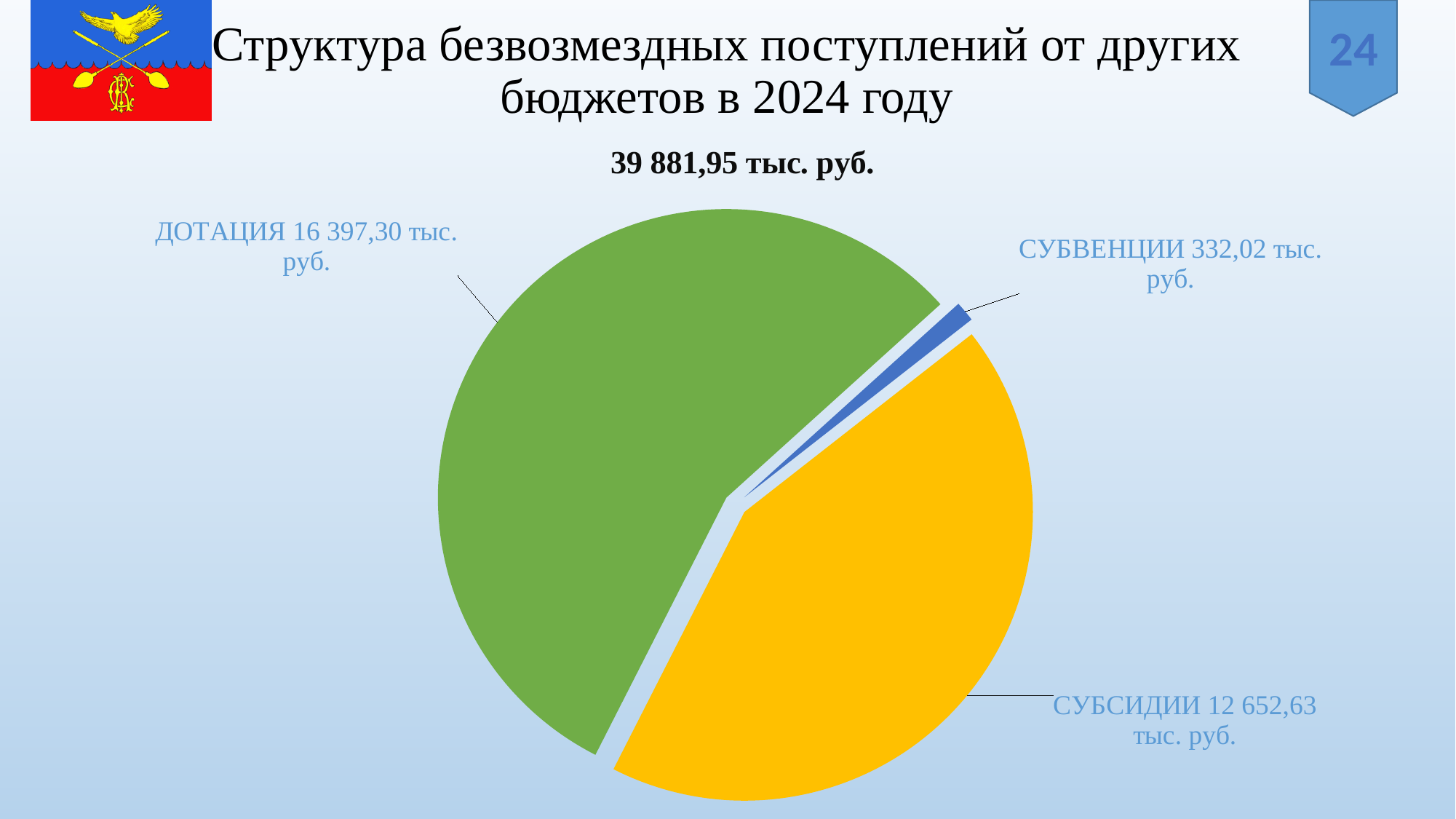
What kind of chart is shown on the slide? Pie chart What is the difference between the values for ДОТАЦИЯ and СУБСИДИИ? 3 744,67 тыс. руб. What colour is the СУБСИДИИ slice in the pie chart? Yellow What is the difference between the values for СУБСИДИИ and СУБВЕНЦИИ? 12 320,61 тыс. руб. What value is shown for СУБВЕНЦИИ in the pie chart? 332,02 тыс. руб. How many slices does the pie chart have? 3 What total amount is printed above the pie chart? 39 881,95 тыс. руб. Which category has the smallest slice of the pie chart? СУБВЕНЦИИ What value is shown for ДОТАЦИЯ in the pie chart? 16 397,30 тыс. руб. Which category has the largest slice of the pie chart? ДОТАЦИЯ What value is shown for СУБСИДИИ in the pie chart? 12 652,63 тыс. руб. Which is larger, the value for ДОТАЦИЯ or the value for СУБСИДИИ? ДОТАЦИЯ